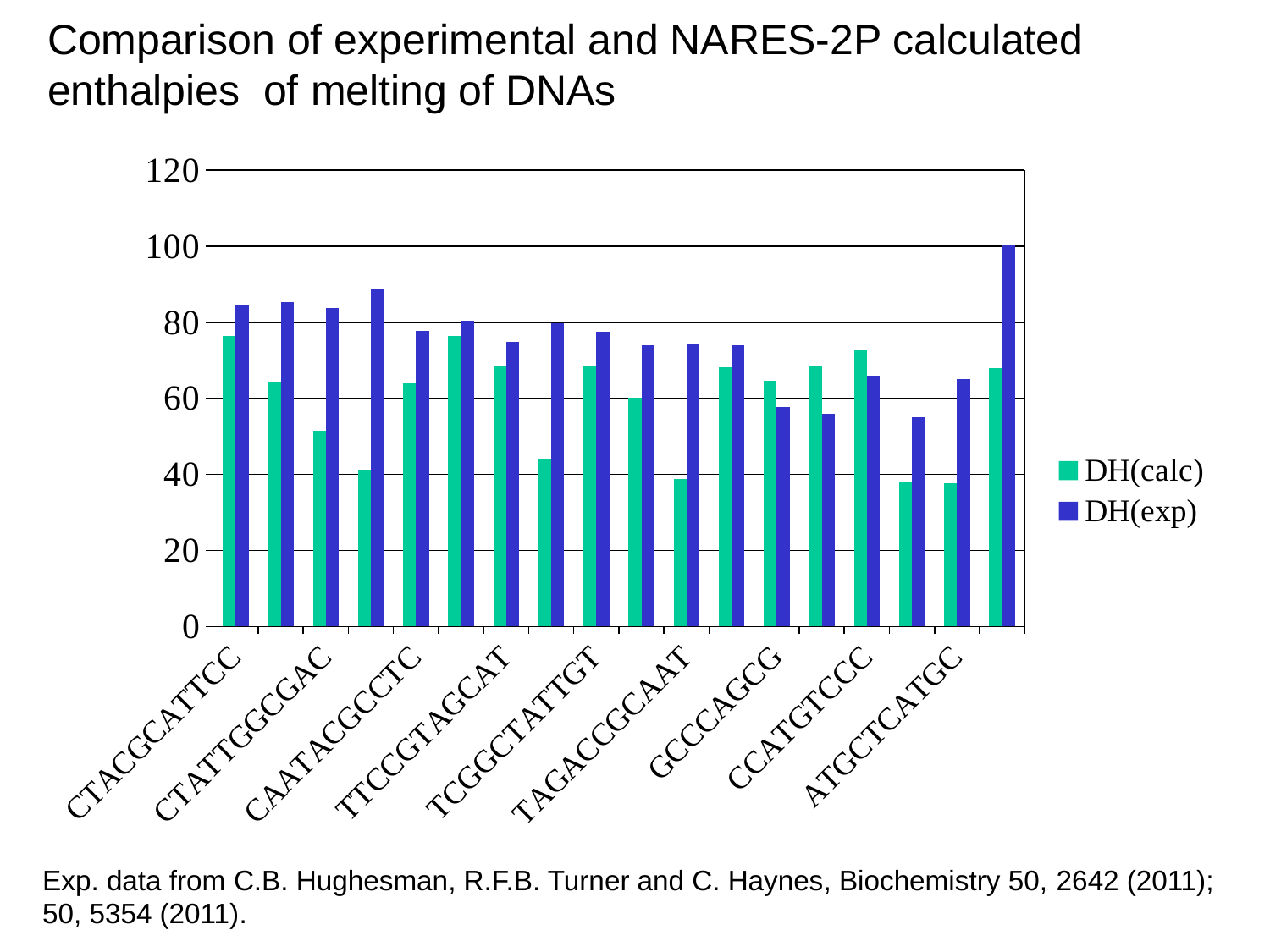
For GCCCAGCG, which is larger, DH(calc) or DH(exp)? DH(calc) What is the highest value shown on the vertical axis? 120 Is the DH(calc) value for CCATGTCCC greater or less than 60? greater What are the two series named in the legend? DH(calc) and DH(exp) Is the DH(exp) value for GCCCAGCG greater or less than 60? less Is the DH(calc) value for CTATTGGCGAC greater or less than 60? less For TAGACCGCAAT, which is larger, DH(calc) or DH(exp)? DH(exp) How many series does the legend list? 2 What kind of chart is shown on the slide? bar chart